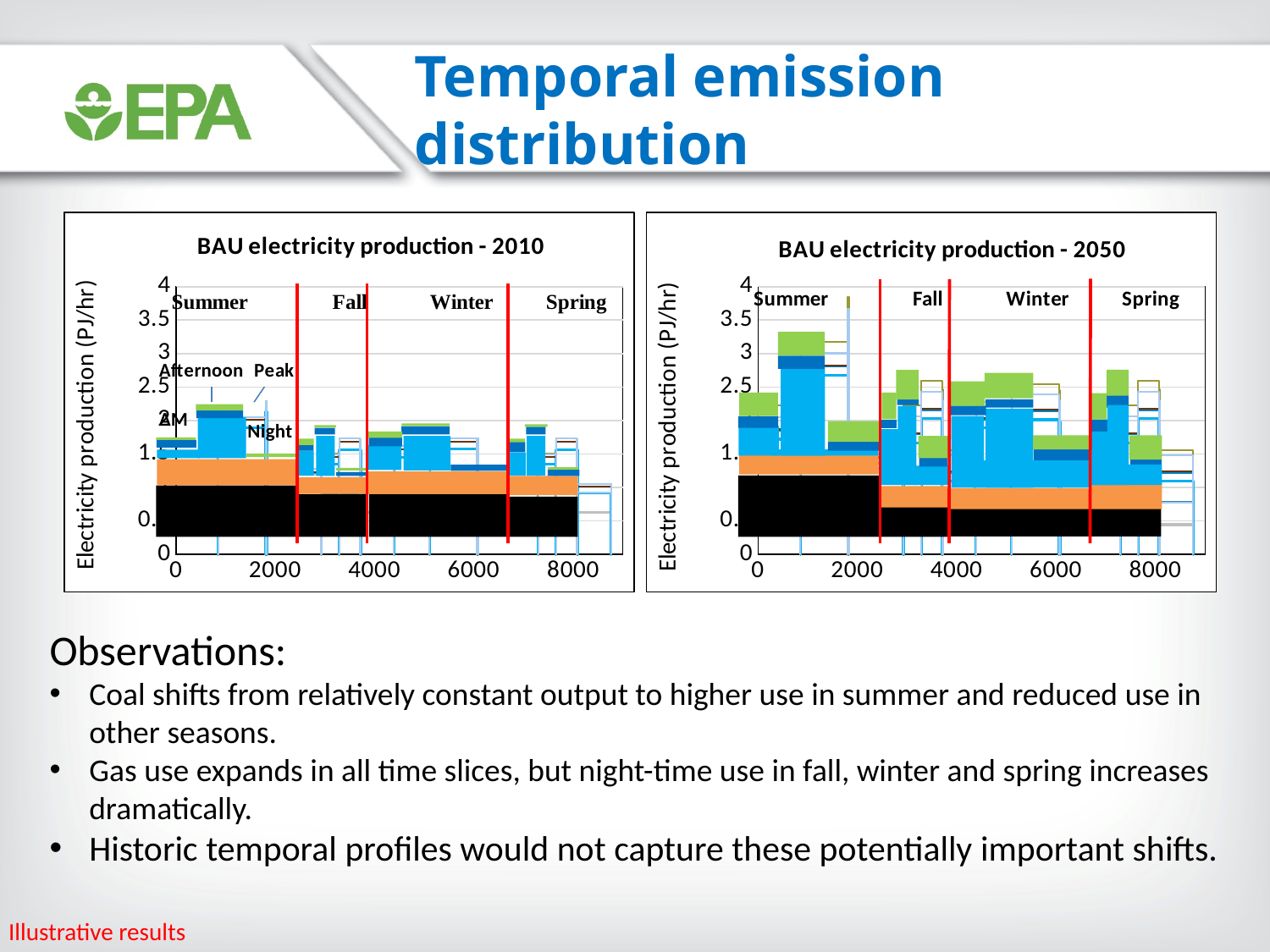
In the BAU electricity production - 2050 chart, is the tallest summer bar greater or less than 3 PJ/hr? greater Which chart shows the higher peak electricity production in summer, the 2010 chart or the 2050 chart? The 2050 chart In the BAU electricity production - 2010 chart, what is the maximum value shown on the vertical axis? 4 What is the title of the left chart? BAU electricity production - 2010 In the BAU electricity production - 2010 chart, which season is labelled first (leftmost) along the horizontal axis? Summer In the BAU electricity production - 2050 chart, what is the label on the vertical axis? Electricity production (PJ/hr) In the BAU electricity production - 2050 chart, how many seasons are labelled along the top of the plot? 4 In the BAU electricity production - 2010 chart, what kind of chart is shown? Stacked bar chart In the BAU electricity production - 2050 chart, is the black (bottom) segment in the fall section greater or less than 1 PJ/hr? less What is the title of the right chart? BAU electricity production - 2050 In the BAU electricity production - 2050 chart, what is the largest tick value shown on the horizontal axis? 8000